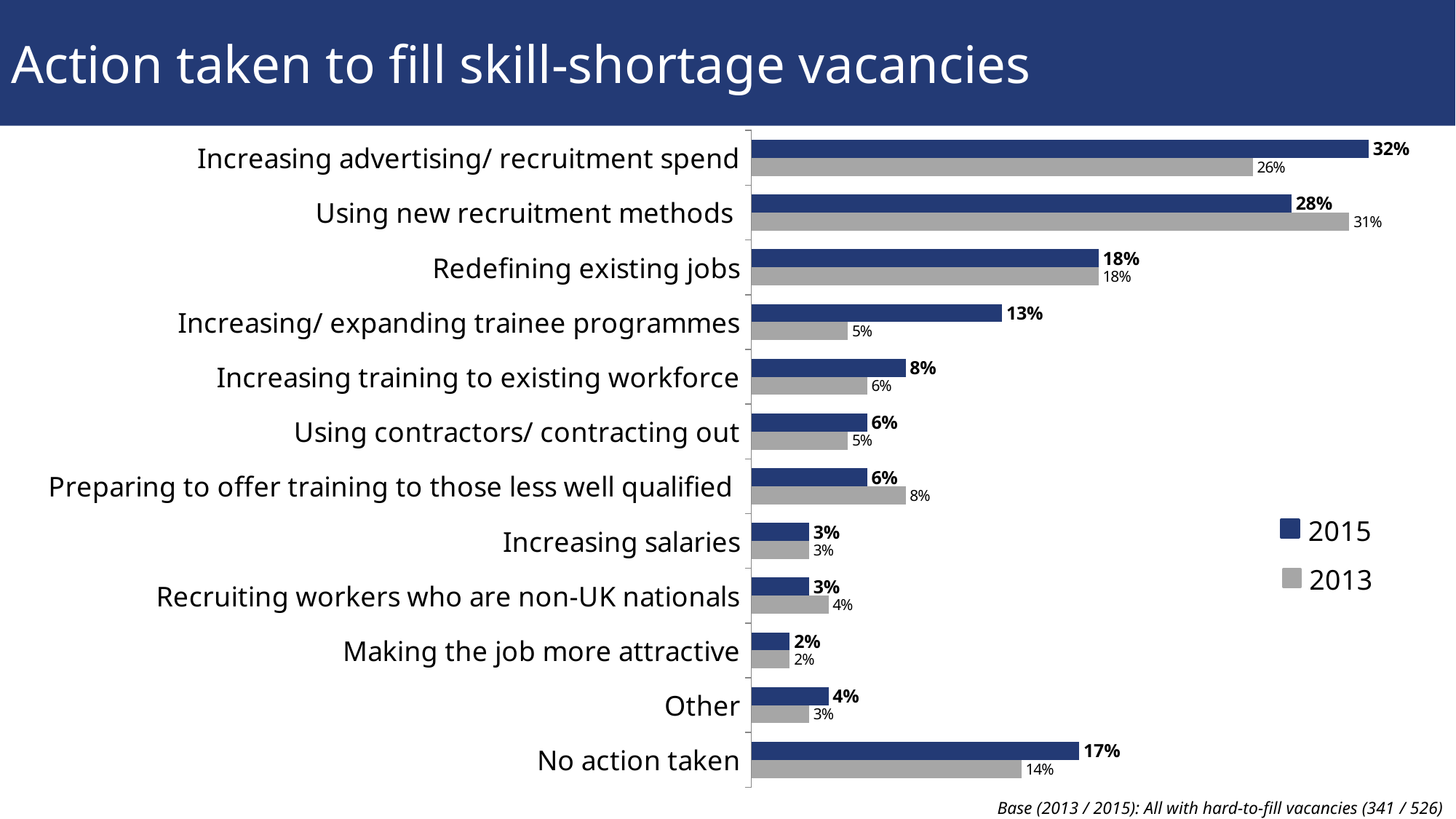
Which category has the highest 2015 value? Increasing advertising/ recruitment spend How many series does the legend list? 2 What is the 2015 value for Increasing advertising/ recruitment spend? 32% Which is larger for Using new recruitment methods, the 2015 value or the 2013 value? 2013 Which category has the lowest 2015 value? Making the job more attractive What is the difference between the 2015 and 2013 values for Increasing/ expanding trainee programmes? 8% What is the 2013 value for Preparing to offer training to those less well qualified? 8% What is the 2013 value for Using new recruitment methods? 31% What kind of chart is shown on the slide? Bar chart Which colour represents the 2013 series in the legend? Grey How many categories are shown on the chart? 12 What is the 2015 value for No action taken? 17%